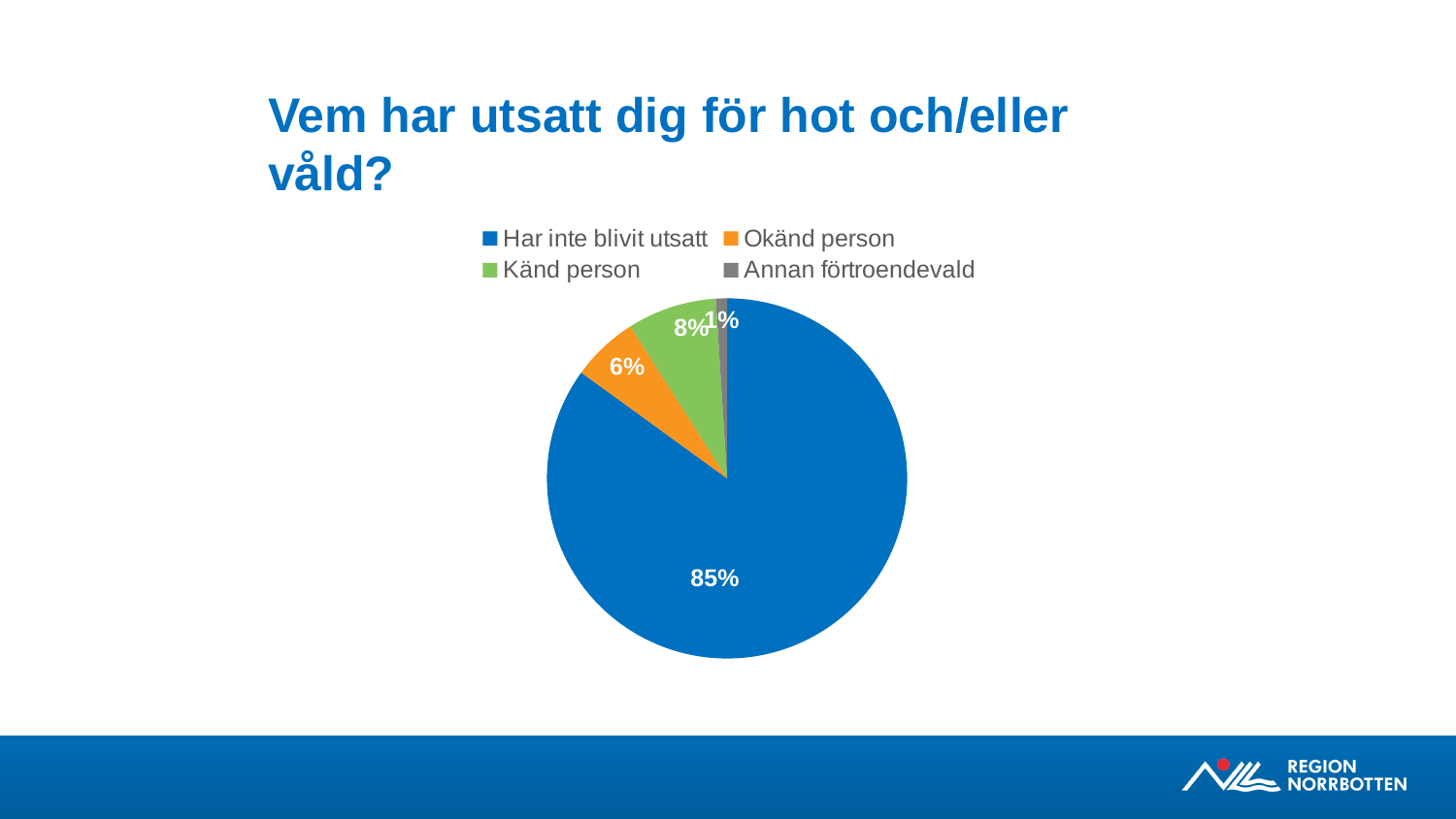
Which category has the smallest slice of the pie? Annan förtroendevald How many categories does the legend list? 4 What percentage is shown for "Okänd person"? 6% What is the difference in percentage points between "Känd person" and "Okänd person"? 2 What percentage is shown for "Har inte blivit utsatt"? 85% What percentage is shown for "Känd person"? 8% What kind of chart is shown on the slide? pie chart What percentage is shown for "Annan förtroendevald"? 1% Which is larger, the slice for "Känd person" or the slice for "Okänd person"? Känd person Which category has the largest slice of the pie? Har inte blivit utsatt What colour is the slice for "Okänd person"? orange What is the title of the chart on the slide? Vem har utsatt dig för hot och/eller våld?